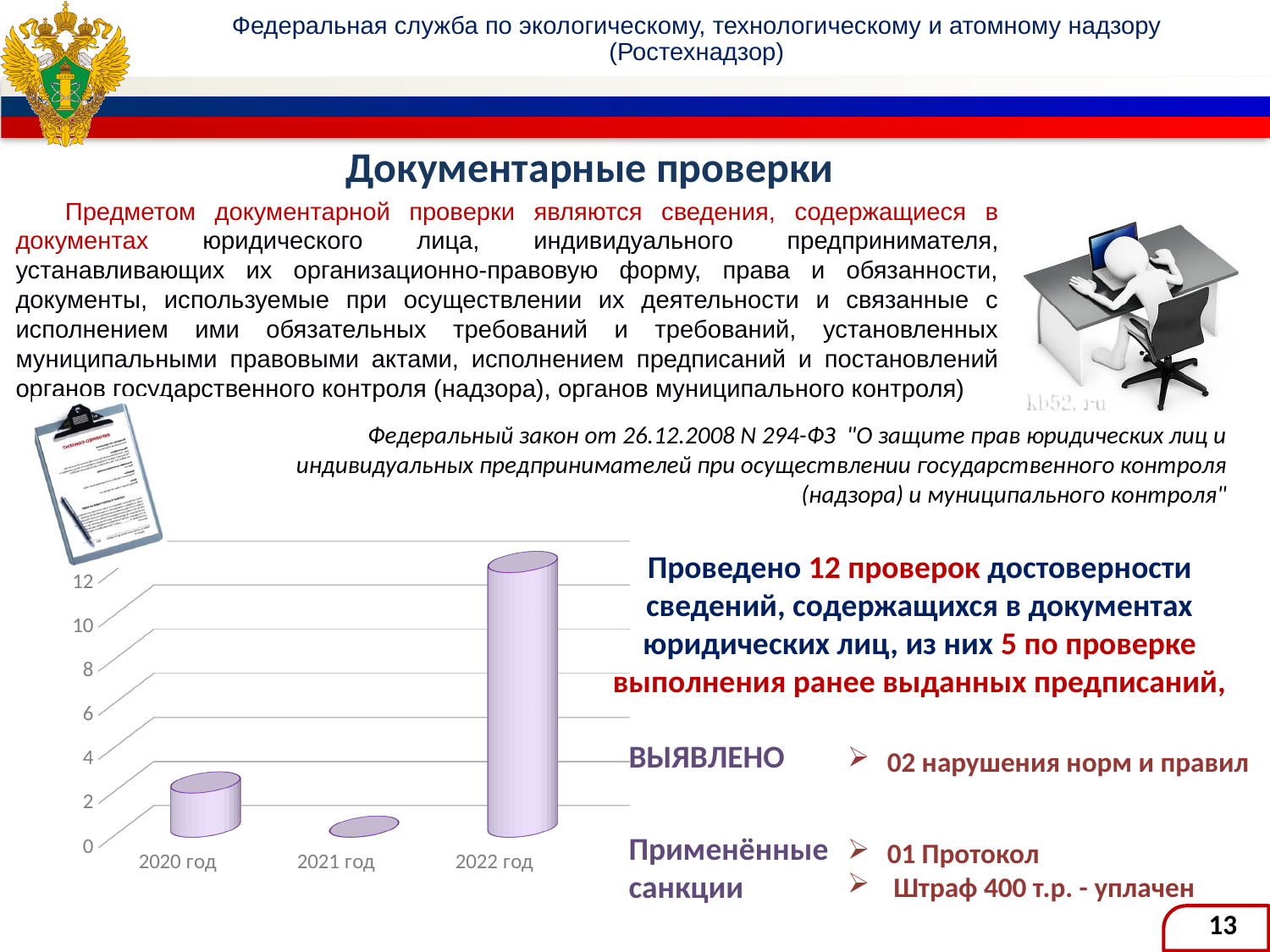
Is the value for 2020 год greater or less than 4? less Which year has the highest value in the chart? 2022 год Is the value for 2022 год greater or less than 10? greater What is the highest tick value shown on the vertical axis of the chart? 12 Does the value rise or fall from 2020 год to 2021 год? fall Which is larger in the chart, the value for 2020 год or the value for 2022 год? 2022 год Which year has the lowest value in the chart? 2021 год What is the label of the first category on the x axis of the chart? 2020 год How many categories (years) are shown on the x axis of the chart? 3 What kind of chart is shown on the slide? bar chart Is the value for 2021 год greater or less than 2? less Does the value rise or fall from 2021 год to 2022 год? rise